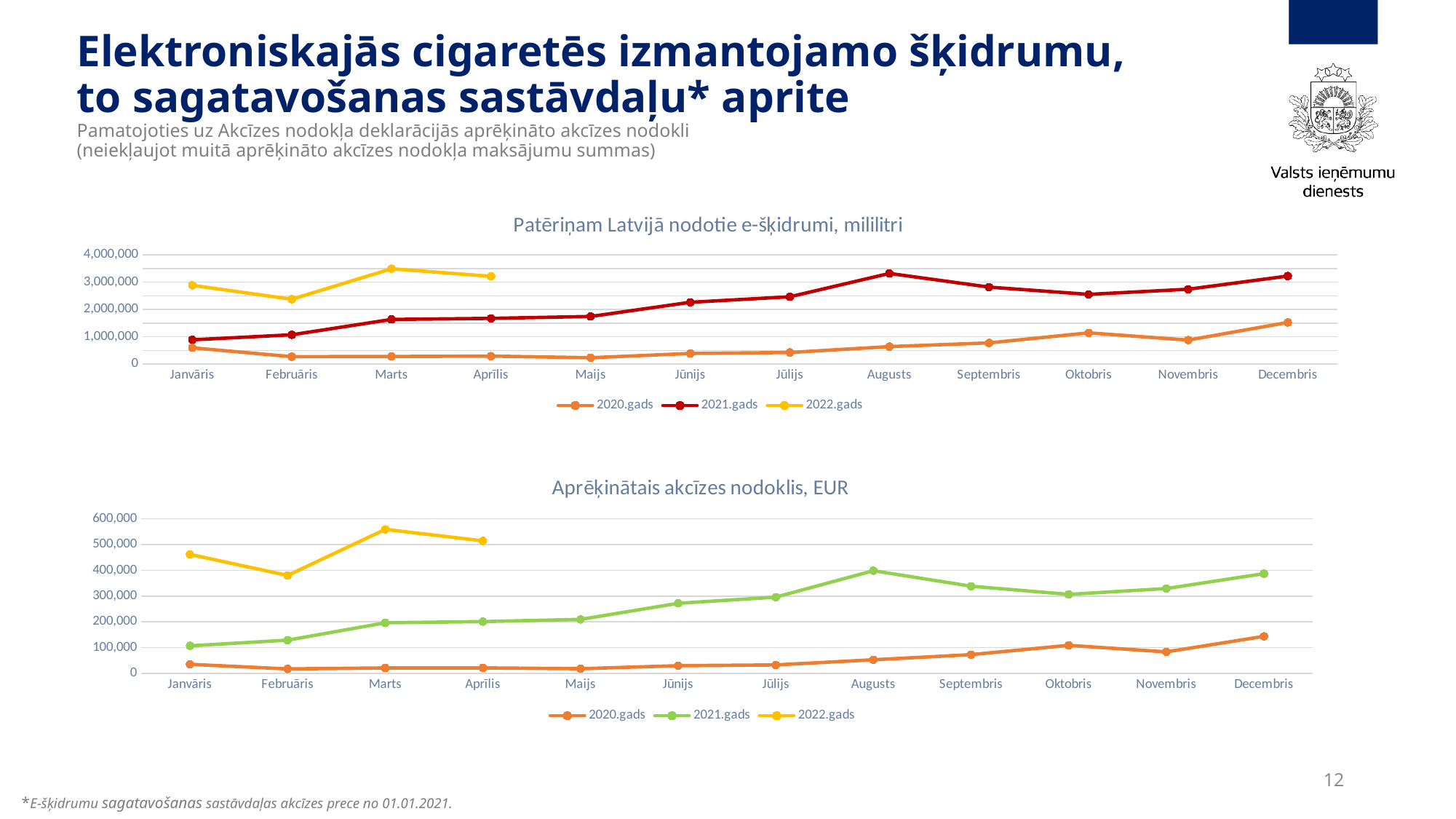
In the top chart 'Patēriņam Latvijā nodotie e-šķidrumi, mililitri', which month has the lowest value for 2021.gads? Janvāris In the top chart 'Patēriņam Latvijā nodotie e-šķidrumi, mililitri', does the 2021.gads series rise or fall from Janvāris to Augusts? Rise In the bottom chart 'Aprēķinātais akcīzes nodoklis, EUR', which month has the highest value for 2020.gads? Decembris In the top chart 'Patēriņam Latvijā nodotie e-šķidrumi, mililitri', is the value for 2020.gads in Maijs greater or less than 1,000,000? less In the bottom chart 'Aprēķinātais akcīzes nodoklis, EUR', is the value for 2022.gads in Marts greater or less than 500,000? greater In the top chart 'Patēriņam Latvijā nodotie e-šķidrumi, mililitri', how many series does the legend list? 3 What kind of chart is the top chart, 'Patēriņam Latvijā nodotie e-šķidrumi, mililitri'? Line chart In the top chart 'Patēriņam Latvijā nodotie e-šķidrumi, mililitri', which month has the highest value for 2022.gads? Marts In the top chart 'Patēriņam Latvijā nodotie e-šķidrumi, mililitri', is the value for 2021.gads in Augusts greater or less than 3,000,000? greater In the bottom chart 'Aprēķinātais akcīzes nodoklis, EUR', how many months have a plotted point for 2022.gads? 4 In the bottom chart 'Aprēķinātais akcīzes nodoklis, EUR', how many months are shown on the x axis? 12 In the bottom chart 'Aprēķinātais akcīzes nodoklis, EUR', which is larger: 2022.gads in Janvāris or 2021.gads in Augusts? 2022.gads in Janvāris